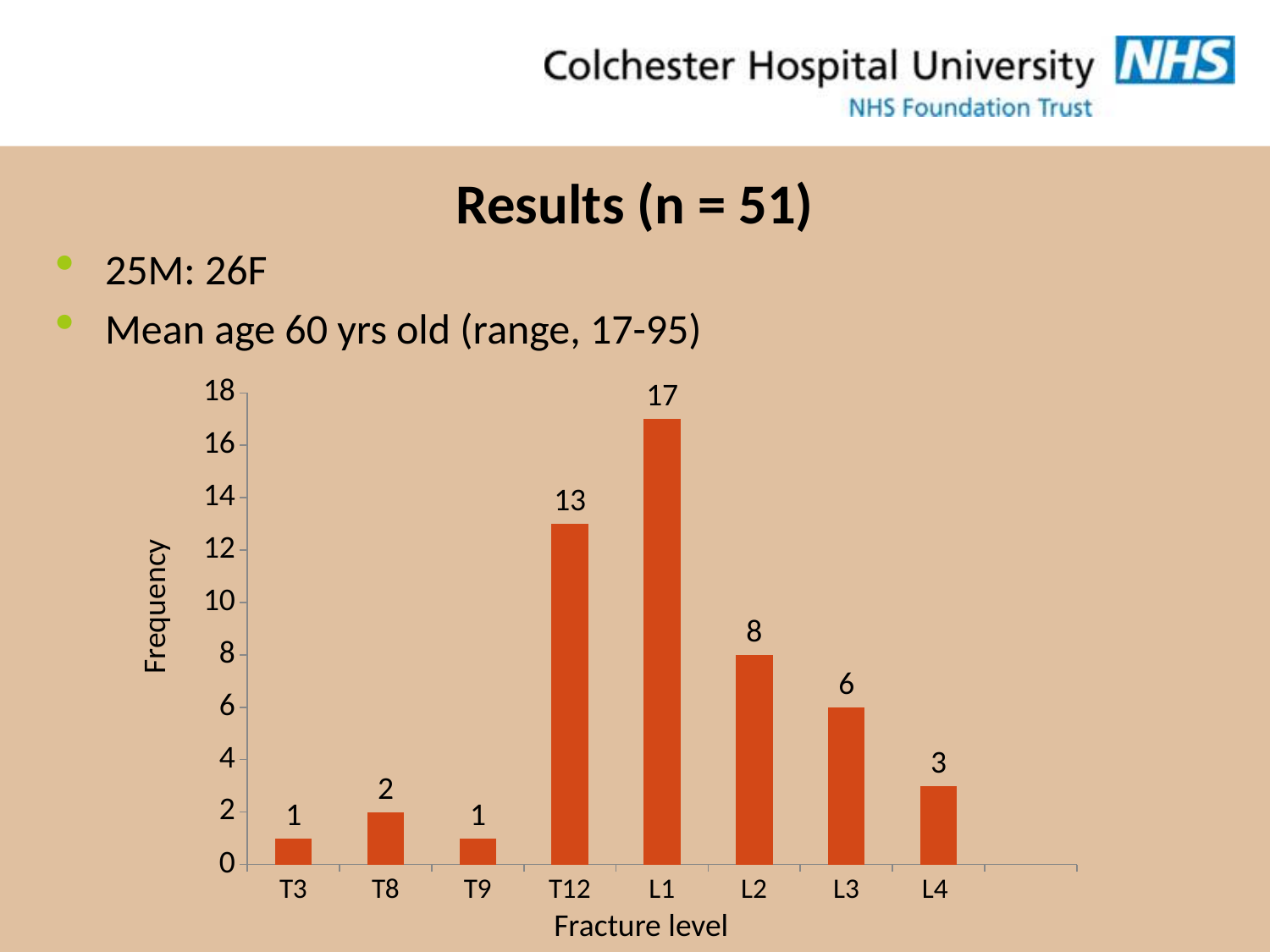
What is the frequency for fracture level L1? 17 What is the frequency for fracture level L4? 3 Which fracture level has the highest frequency? L1 What is the label of the x axis of the chart? Fracture level What kind of chart is shown on the slide? Bar chart Which has a higher frequency, L2 or L3? L2 What is the label of the y axis of the chart? Frequency How many fracture levels are shown on the x axis? 8 What is the difference in frequency between L1 and T12? 4 What is the frequency for fracture level T12? 13 Which has a higher frequency, T8 or L4? L4 What is the difference in frequency between L2 and L3? 2